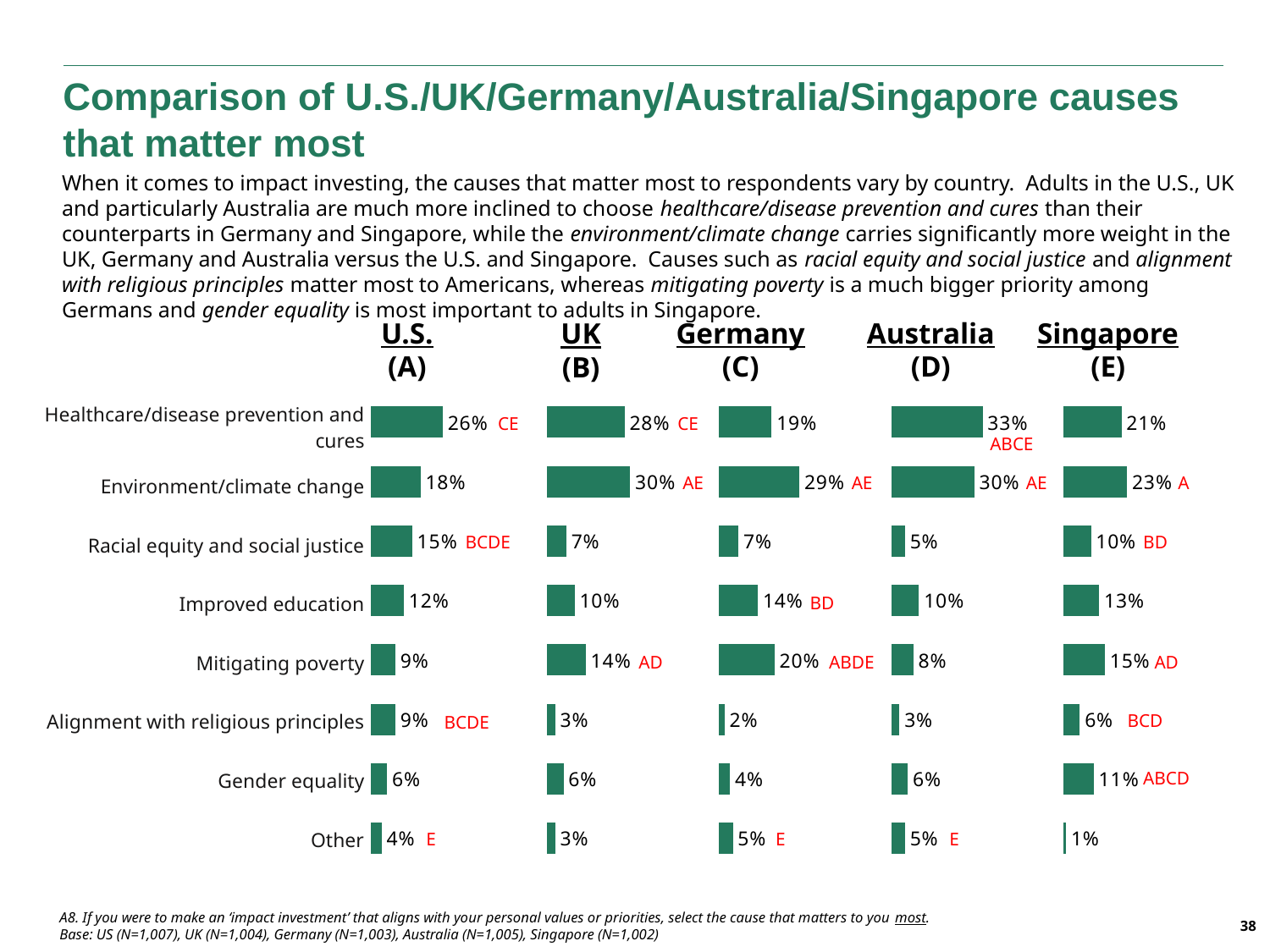
In the U.S. (A) chart, what percentage is shown for Racial equity and social justice? 15% In the U.S. (A) chart, what percentage is shown for Healthcare/disease prevention and cures? 26% In the Australia (D) chart, which cause has the highest percentage? Healthcare/disease prevention and cures In the Singapore (E) chart, which cause has the lowest percentage? Other In the Germany (C) chart, what percentage is shown for Mitigating poverty? 20% In the Germany (C) chart, which cause has the highest percentage? Environment/climate change How many countries are compared in the charts on the slide? 5 Which is larger: Mitigating poverty in the Germany (C) chart or Mitigating poverty in the Australia (D) chart? Germany (C) In the UK (B) chart, what is the difference between Environment/climate change and Healthcare/disease prevention and cures? 2% How many causes are listed in each country's chart? 8 What type of chart is used to show the causes for each country? Bar chart In the Singapore (E) chart, what percentage is shown for Gender equality? 11%